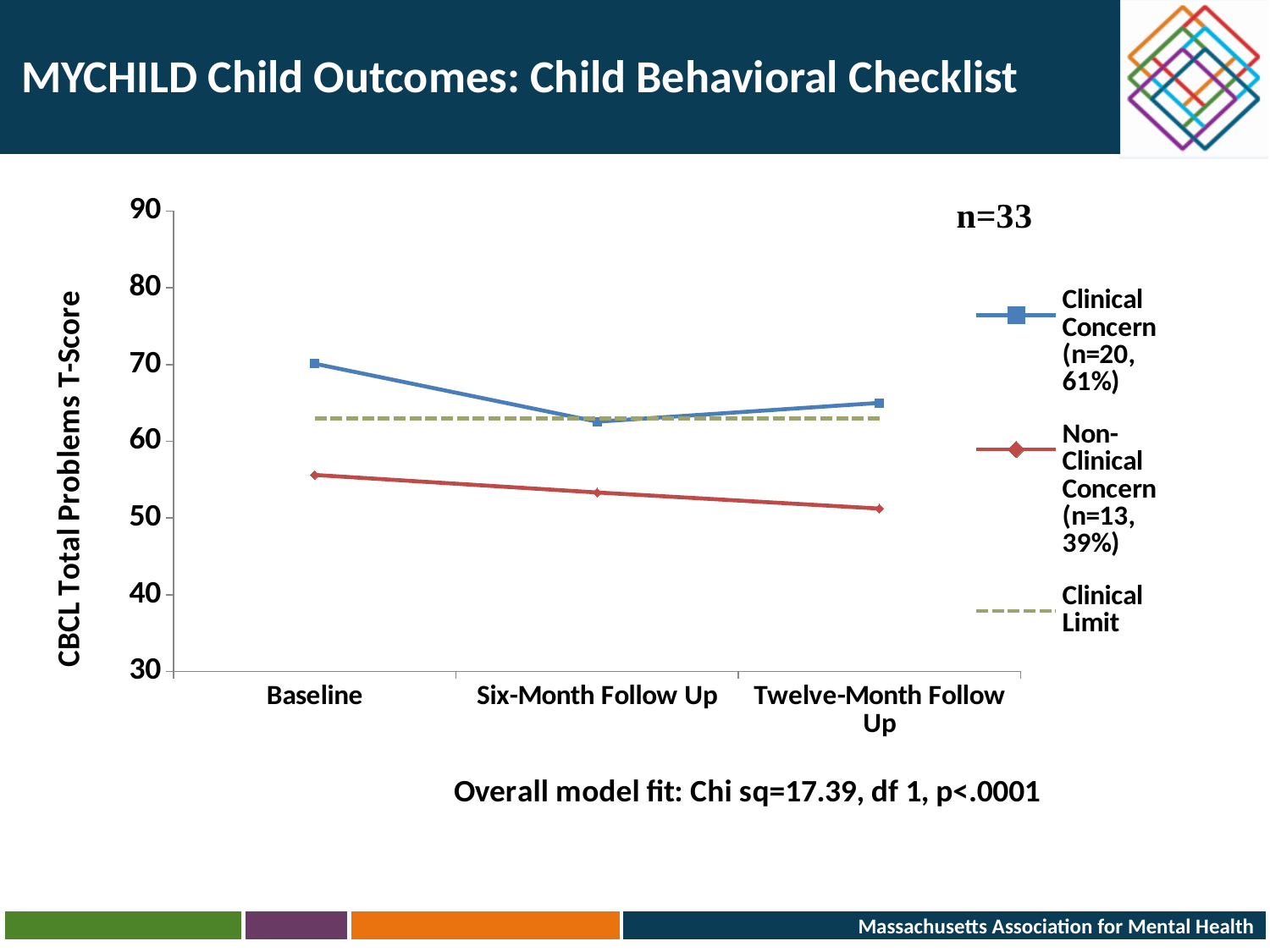
Is the Non-Clinical Concern value at Twelve-Month Follow Up greater or less than 60? less At which time point is the Clinical Concern value highest? Baseline Does the Non-Clinical Concern line rise or fall from Baseline to Twelve-Month Follow Up? fall At which time point is the Non-Clinical Concern value lowest? Twelve-Month Follow Up At Baseline, which series has the higher value: Clinical Concern or Non-Clinical Concern? Clinical Concern What sample size is shown for the Clinical Concern group in the legend? n=20, 61% What kind of chart is shown on the slide? line chart How many time points are shown on the x axis? 3 How many series does the legend list? 3 Is the Clinical Concern value at Six-Month Follow Up greater or less than 70? less Is the Clinical Concern value at Baseline greater or less than 60? greater What is the title of the y axis? CBCL Total Problems T-Score